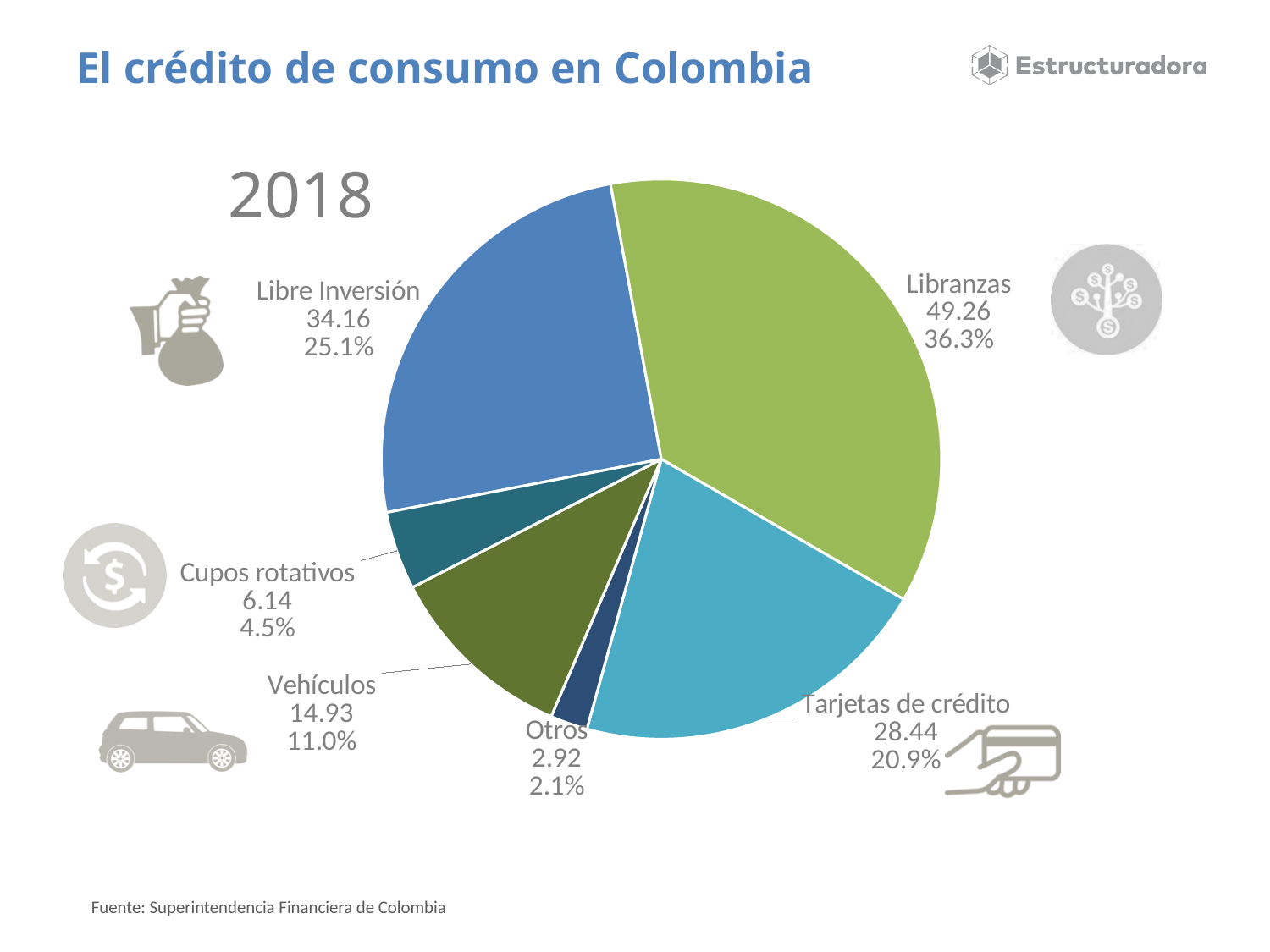
Which category has the smallest slice? Otros Which is larger, the value for Cupos rotativos or the value for Vehículos? Vehículos What year is shown next to the pie chart? 2018 What is the value for Libranzas? 49.26 Which category has the largest slice? Libranzas What is the difference between the values for Libranzas and Libre Inversión? 15.10 How many categories are shown in the pie chart? 6 What is the value for Vehículos? 14.93 What share of the pie does Libre Inversión represent? 25.1% What share of the pie does Cupos rotativos represent? 4.5% What share of the pie does Tarjetas de crédito represent? 20.9% What kind of chart is shown on the slide? pie chart